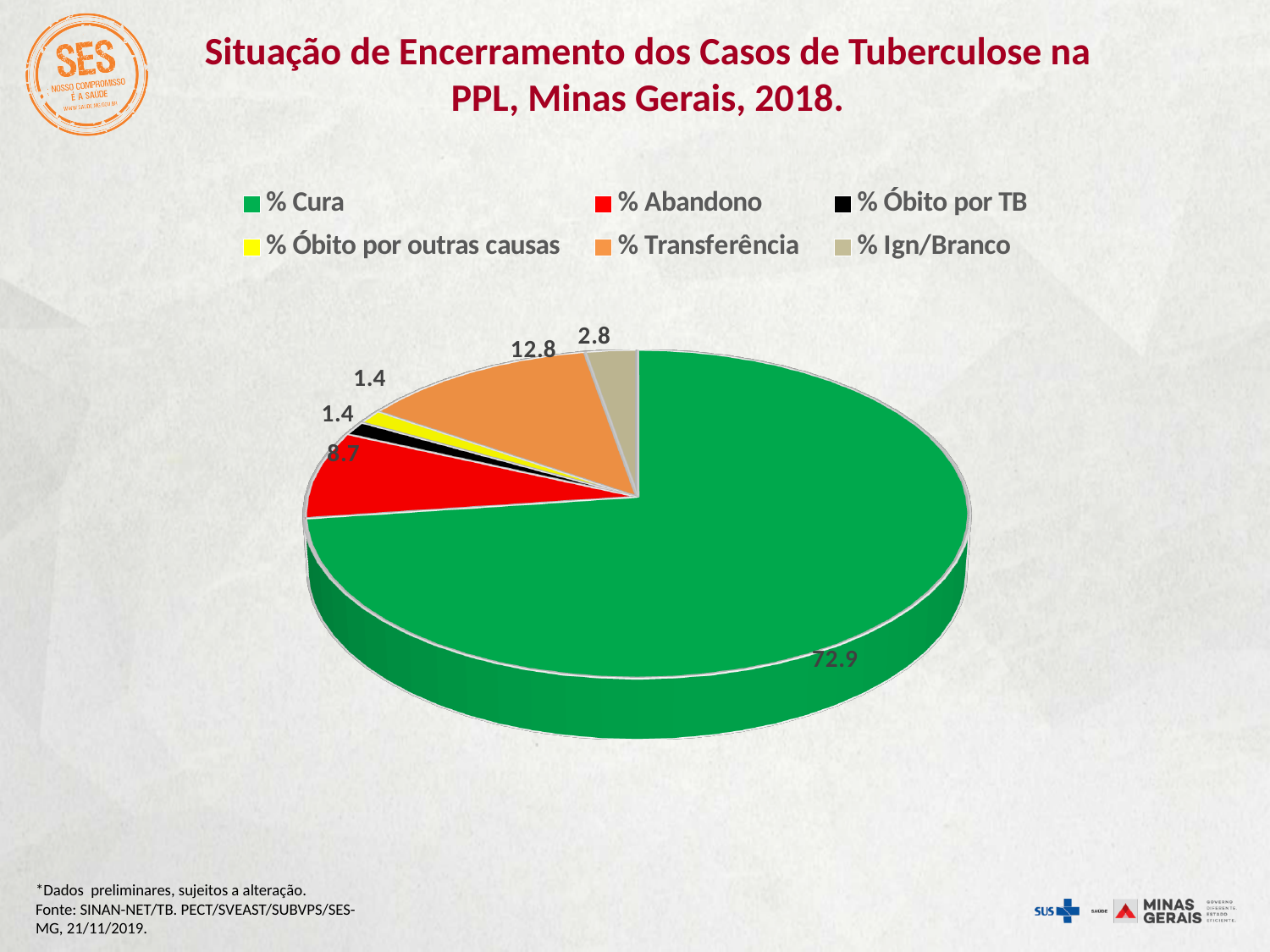
What is the value for % Ign/Branco? 2.8 What is the value for % Óbito por TB? 1.4 What is the title of the chart? Situação de Encerramento dos Casos de Tuberculose na PPL, Minas Gerais, 2018. What type of chart is shown on the slide? pie chart How many categories does the legend list? 6 What colour is the slice for % Transferência? orange What is the difference between the values for % Cura and % Transferência? 60.1 What is the value for % Cura? 72.9 Which category has the largest slice of the pie? % Cura What is the value for % Abandono? 8.7 Which is larger, the value for % Transferência or the value for % Abandono? % Transferência What is the value for % Transferência? 12.8